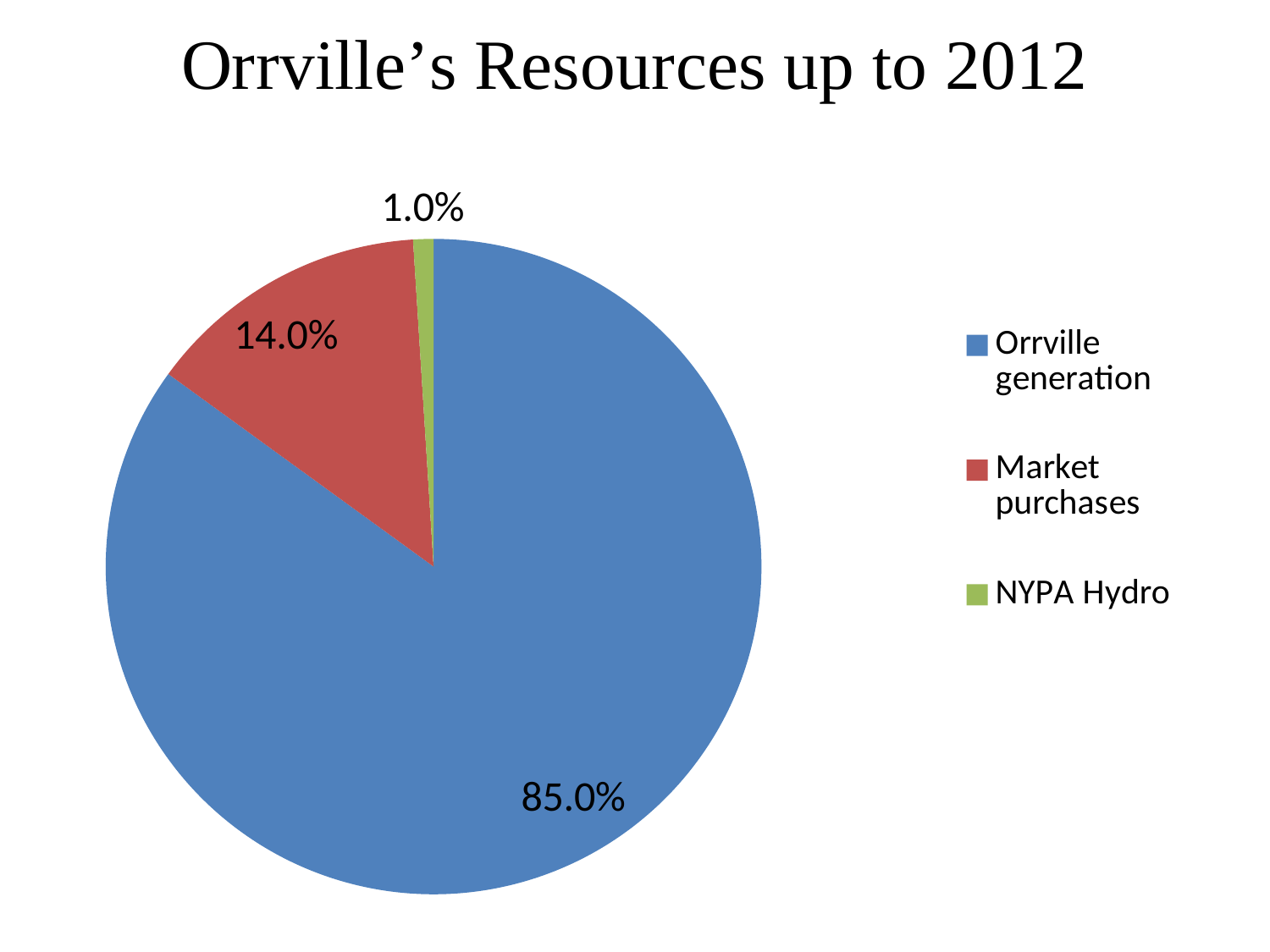
What is the difference in percentage points between Market purchases and NYPA Hydro? 13.0% Which category has the smallest slice of the pie? NYPA Hydro What is the title of the slide? Orrville's Resources up to 2012 What share of the pie does Orrville generation account for? 85.0% What kind of chart is shown on the slide? Pie chart What is the difference in percentage points between Orrville generation and Market purchases? 71.0% Which is larger, Market purchases or NYPA Hydro? Market purchases Which category has the largest slice of the pie? Orrville generation What colour is the slice for Market purchases? Red What share of the pie does Market purchases account for? 14.0% How many categories are shown in the pie chart? 3 What share of the pie does NYPA Hydro account for? 1.0%